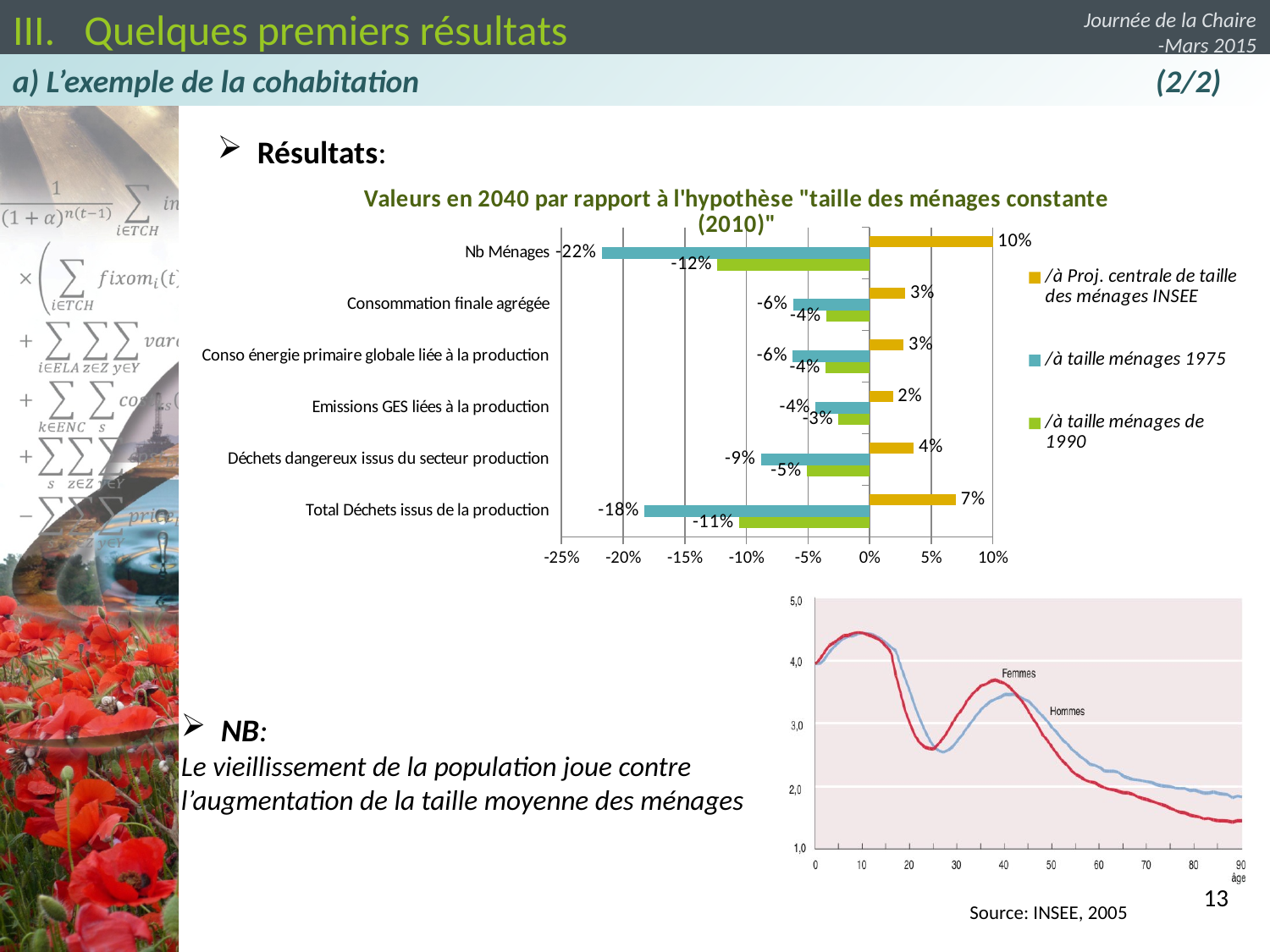
How many series does the legend of the bar chart 'Valeurs en 2040 par rapport à l'hypothèse "taille des ménages constante (2010)"' list? 3 In the bar chart 'Valeurs en 2040 par rapport à l'hypothèse "taille des ménages constante (2010)"', which category has the lowest value in the series '/à taille ménages de 1990'? Nb Ménages What kind of chart is the chart at the top of the slide titled 'Valeurs en 2040 par rapport à l'hypothèse "taille des ménages constante (2010)"'? Bar chart What kind of chart is the chart at the bottom right of the slide (Source: INSEE, 2005)? Line chart In the bar chart 'Valeurs en 2040 par rapport à l'hypothèse "taille des ménages constante (2010)"', what is the value for Total Déchets issus de la production in the series '/à Proj. centrale de taille des ménages INSEE'? 7% In the bar chart 'Valeurs en 2040 par rapport à l'hypothèse "taille des ménages constante (2010)"', what is the difference between the '/à taille ménages 1975' values for Nb Ménages and Total Déchets issus de la production? 4 percentage points In the bar chart 'Valeurs en 2040 par rapport à l'hypothèse "taille des ménages constante (2010)"', which category has the highest value in the series '/à Proj. centrale de taille des ménages INSEE'? Nb Ménages How many categories are shown in the bar chart 'Valeurs en 2040 par rapport à l'hypothèse "taille des ménages constante (2010)"'? 6 In the line chart at the bottom right of the slide (Source: INSEE, 2005), is the value for Femmes at age 90 greater or less than 2,0? less In the bar chart 'Valeurs en 2040 par rapport à l'hypothèse "taille des ménages constante (2010)"', which is larger in the series '/à Proj. centrale de taille des ménages INSEE': Déchets dangereux issus du secteur production or Emissions GES liées à la production? Déchets dangereux issus du secteur production In the bar chart 'Valeurs en 2040 par rapport à l'hypothèse "taille des ménages constante (2010)"', what is the value for Déchets dangereux issus du secteur production in the series '/à taille ménages de 1990'? -5% In the bar chart 'Valeurs en 2040 par rapport à l'hypothèse "taille des ménages constante (2010)"', what is the value for Nb Ménages in the series '/à taille ménages 1975'? -22%